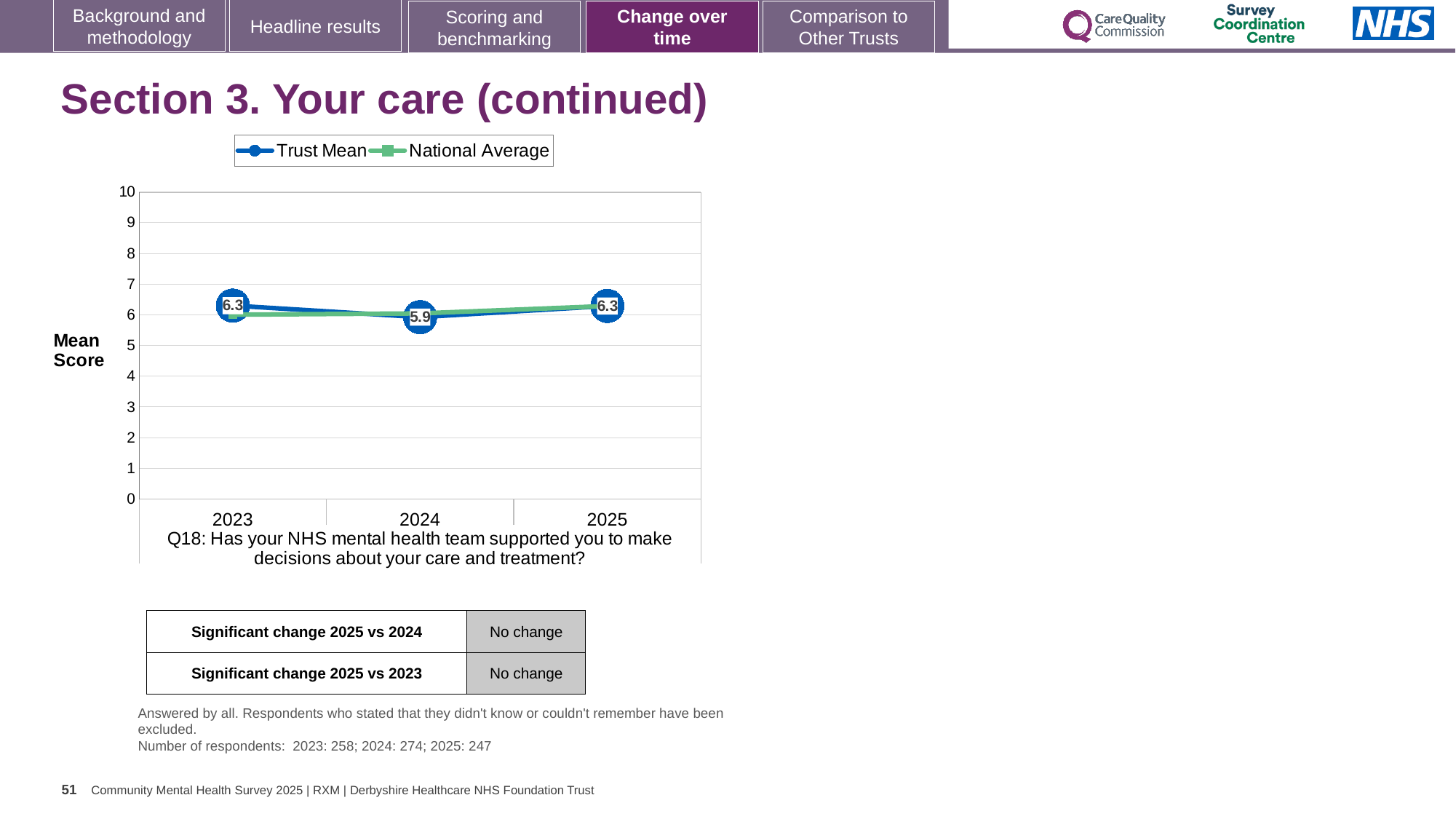
Does the Trust Mean score rise or fall from 2024 to 2025? Rise What is the label on the y axis of the chart? Mean Score Which is larger, the Trust Mean score in 2024 or in 2025? 2025 What is the Trust Mean score for 2025? 6.3 Is the National Average value for 2023 greater or less than 5? greater What is the Trust Mean score for 2024? 5.9 What is the Trust Mean score for 2023? 6.3 How many years are shown on the x axis of the chart? 3 What is the difference between the Trust Mean score in 2023 and in 2024? 0.4 In which year is the Trust Mean score lowest? 2024 What kind of chart is shown on the slide? Line chart How many series does the chart legend list? 2